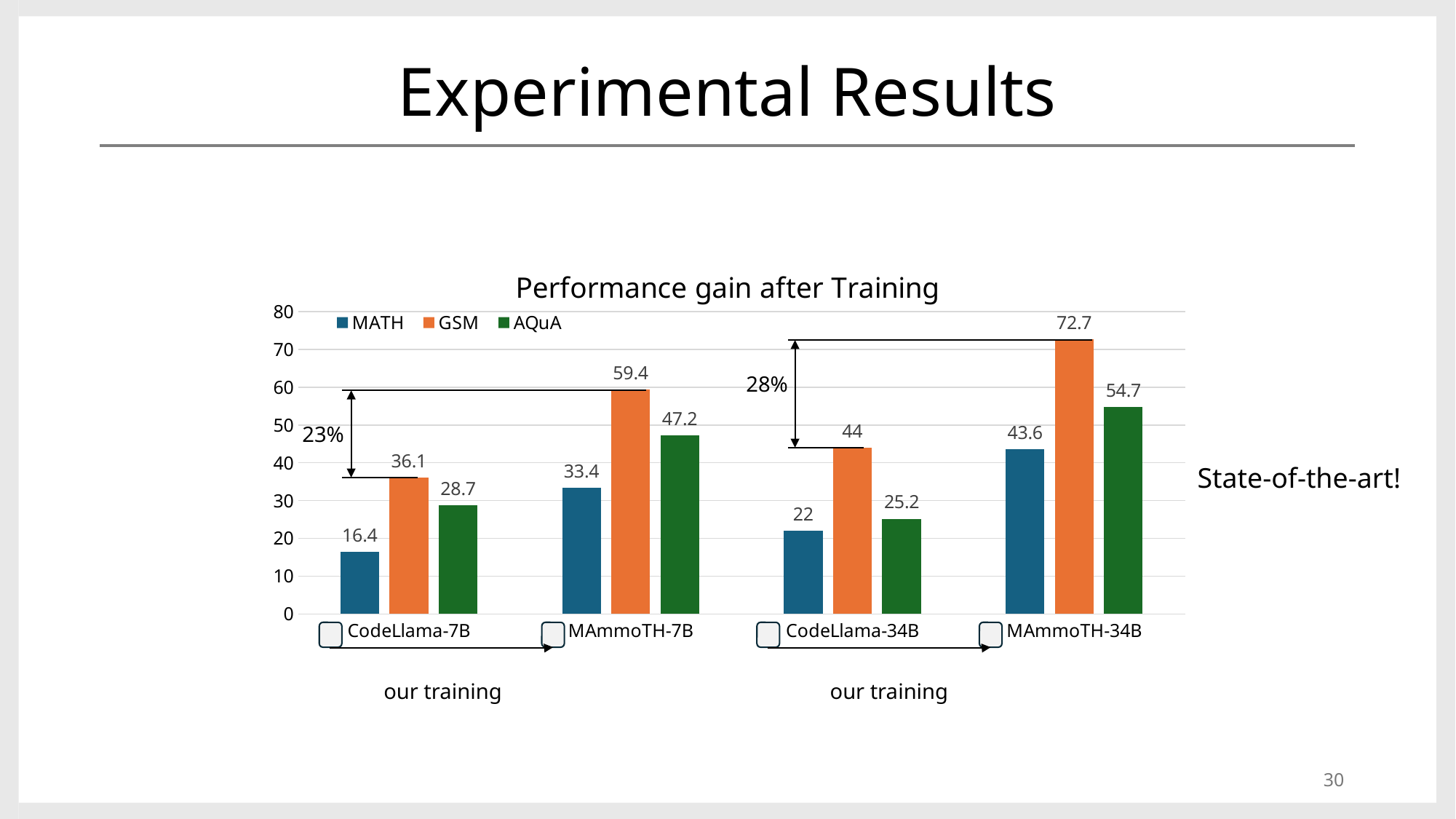
Which is larger, the AQuA value for MAmmoTH-34B or the GSM value for MAmmoTH-7B? GSM value for MAmmoTH-7B Which category has the lowest MATH value? CodeLlama-7B What is the GSM value for MAmmoTH-34B? 72.7 How many series does the legend list? 3 What is the title of the chart? Performance gain after Training What is the MATH value for CodeLlama-7B? 16.4 Which category has the highest GSM value? MAmmoTH-34B What is the AQuA value for MAmmoTH-7B? 47.2 What is the difference between the GSM values for MAmmoTH-7B and CodeLlama-7B? 23.3 What kind of chart is shown? bar chart How many categories are shown on the x axis? 4 Is the MATH value for MAmmoTH-34B greater or less than 40? greater